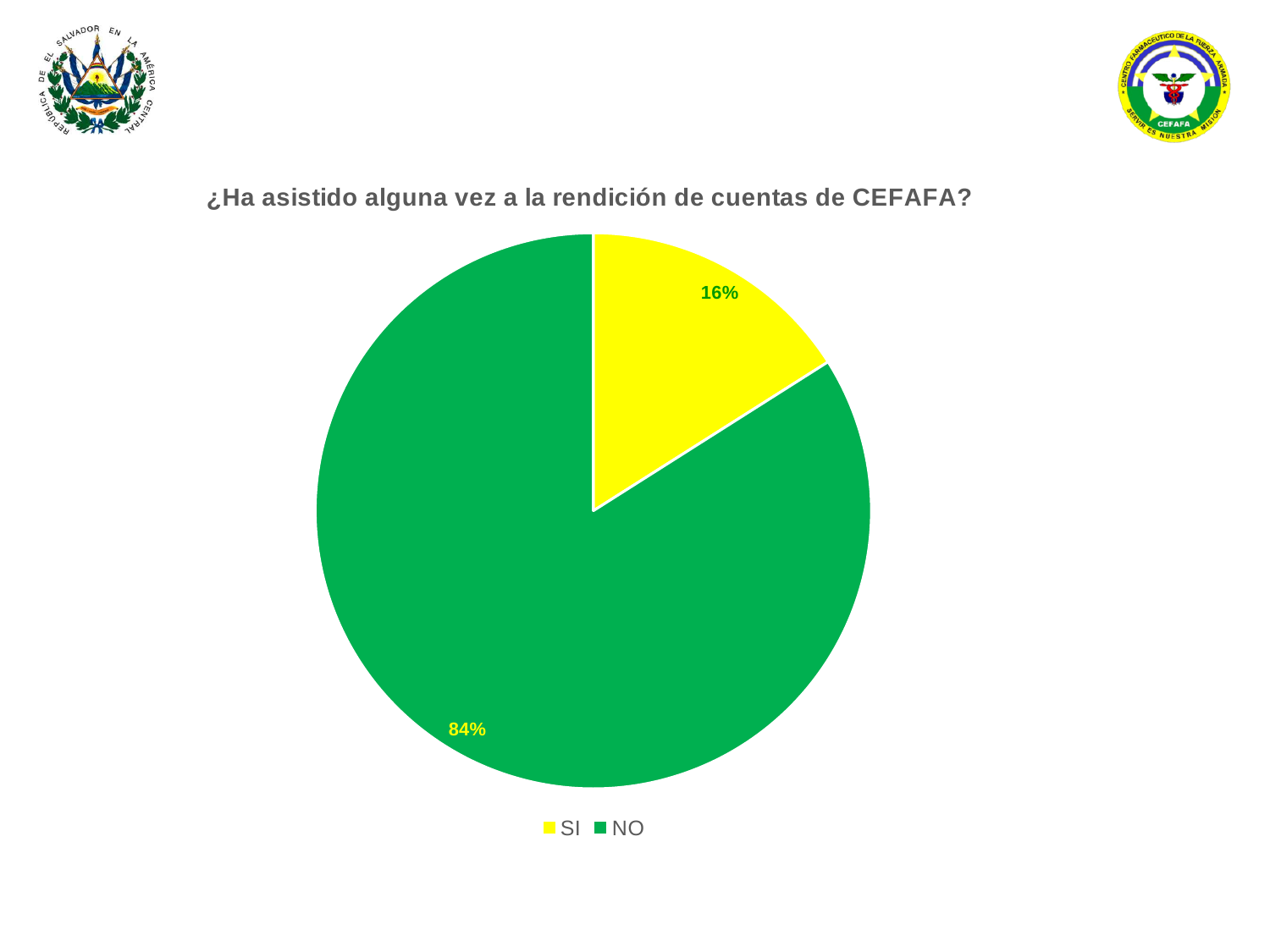
What percentage of respondents answered SI? 16% How many slices does the pie chart have? 2 Which slice is larger, SI or NO? NO Which response has the largest share of the pie? NO How many entries does the legend list? 2 What kind of chart is shown on the slide? pie chart What colour is the SI slice? yellow What percentage of respondents answered NO? 84% Which response has the smallest share of the pie? SI What share of the pie does the NO slice represent? 84% What is the difference in percentage points between the NO and SI slices? 68 What is the title of the chart? ¿Ha asistido alguna vez a la rendición de cuentas de CEFAFA?